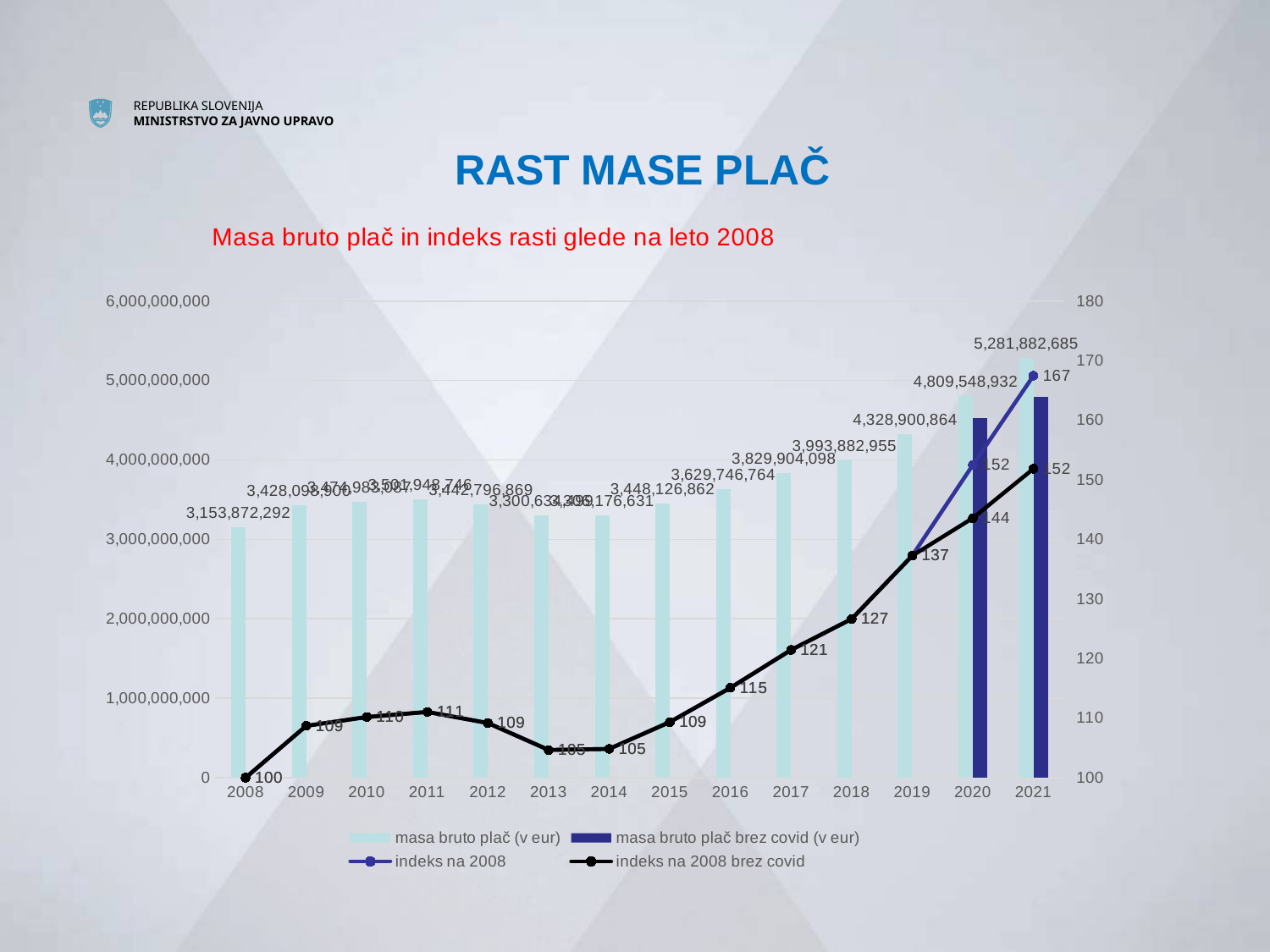
What is the difference between masa bruto plač (v eur) in 2021 and 2020? 472,333,753 How many series does the legend list? 4 Which is larger, the indeks na 2008 for 2021 or the indeks na 2008 brez covid for 2021? indeks na 2008 for 2021 What is the value of masa bruto plač (v eur) for 2008? 3,153,872,292 Which year has the lowest masa bruto plač (v eur)? 2008 How many years are shown on the x axis? 14 What is the indeks na 2008 brez covid value for 2020? 144 What is the value of masa bruto plač (v eur) for 2019? 4,328,900,864 What is the indeks na 2008 value for 2021? 167 Does the indeks na 2008 brez covid line rise or fall from 2014 to 2021? rise What is the value of masa bruto plač (v eur) for 2021? 5,281,882,685 Which year has the highest masa bruto plač (v eur)? 2021